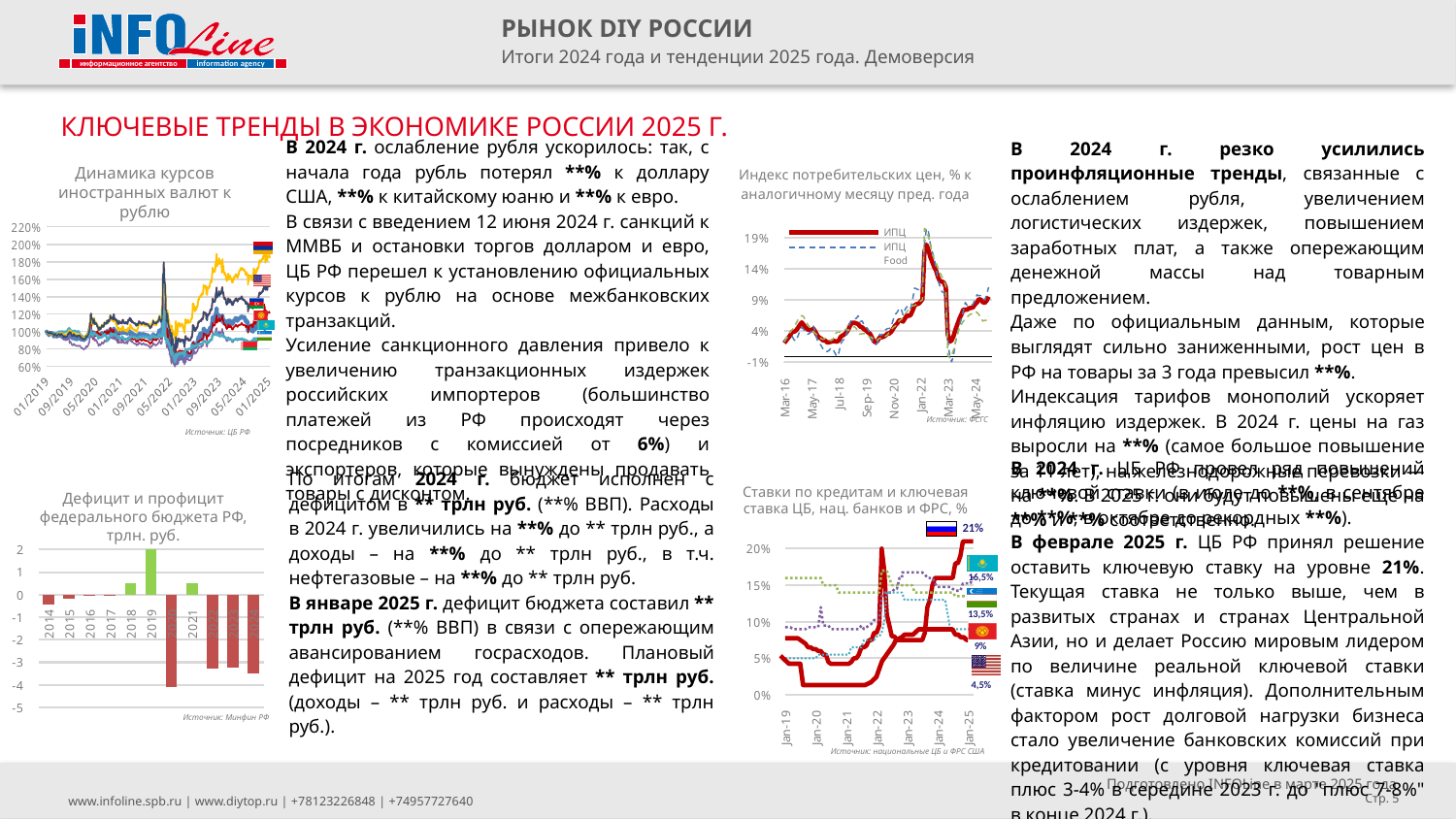
What are the two legend entries on the 'Индекс потребительских цен' chart? ИПЦ and ИПЦ Food What kind of chart is the 'Дефицит и профицит федерального бюджета РФ, трлн руб.' chart? bar chart What kind of chart is the 'Индекс потребительских цен, % к аналогичному месяцу пред. года' chart? line chart What is the highest value shown on the y-axis of the 'Динамика курсов иностранных валют к рублю' chart? 220% On the 'Дефицит и профицит федерального бюджета РФ' chart, is the value for 2019 greater or less than 1? greater On the 'Ставки по кредитам и ключевая ставка' chart, which labelled end value is the lowest? 4,5% On the 'Ставки по кредитам и ключевая ставка' chart, what is the difference between the 21% and the 4,5% labelled values? 16,5 percentage points On the 'Ставки по кредитам и ключевая ставка' chart, which labelled end value is the highest? 21% On the 'Дефицит и профицит федерального бюджета РФ' chart, which labelled year has the highest (largest positive) bar? 2019 On the 'Ставки по кредитам и ключевая ставка ЦБ, нац. банков и ФРС, %' chart, what is the labelled value for the line marked with the Russian flag? 21% How many series does the legend of the 'Индекс потребительских цен' chart list? 2 On the 'Ставки по кредитам и ключевая ставка ЦБ, нац. банков и ФРС, %' chart, what is the labelled value for the line marked with the US flag? 4,5%